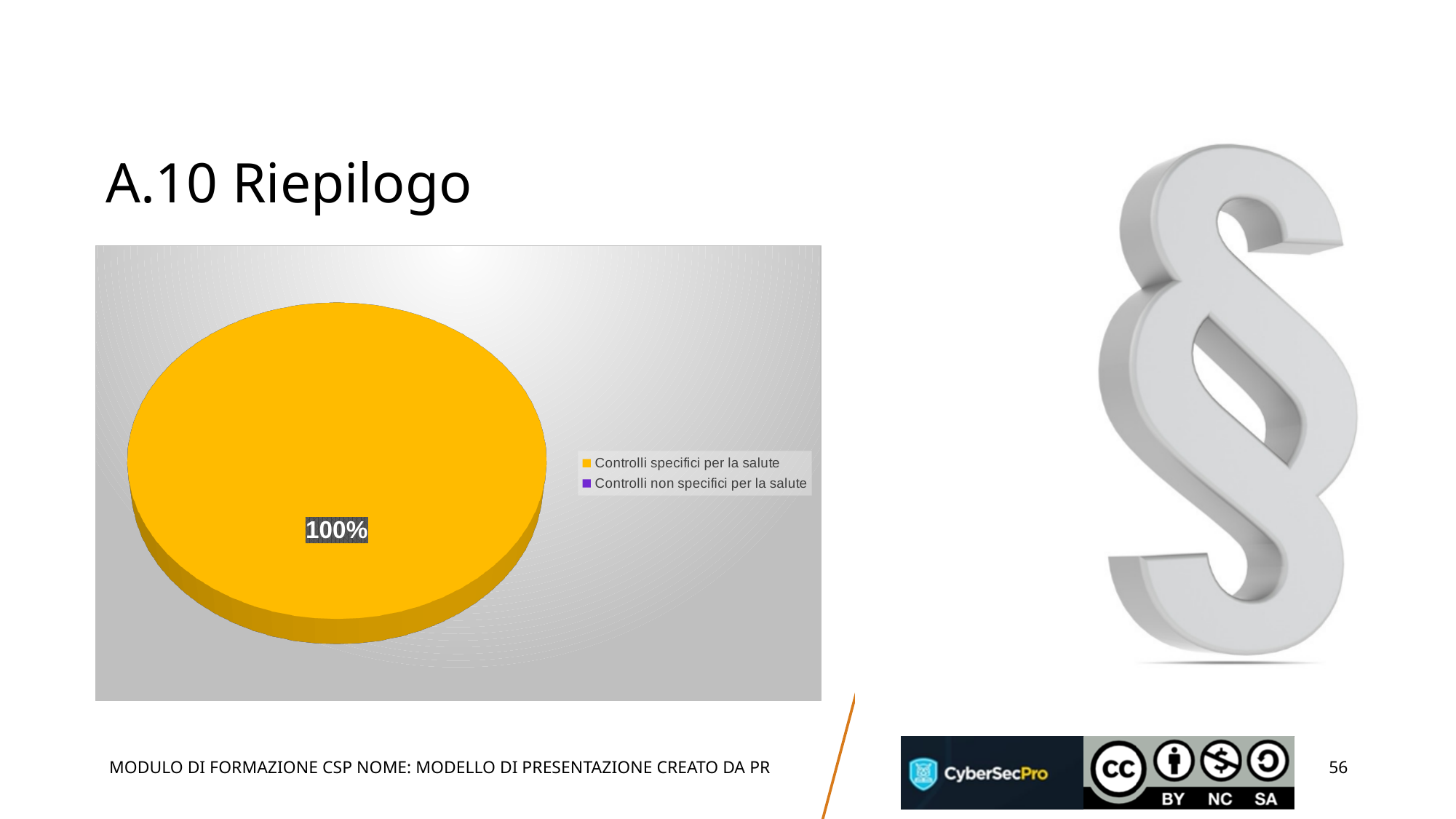
Which is larger in the pie chart, the slice for Controlli specifici per la salute or the slice for Controlli non specifici per la salute? Controlli specifici per la salute Which category has the largest slice in the pie chart? Controlli specifici per la salute What percentage is printed on the pie chart? 100% What share of the pie does the slice for Controlli specifici per la salute represent? 100% What kind of chart is shown on the slide? pie chart Is the share for Controlli specifici per la salute greater or less than 50%? greater Which legend entry is shown in purple? Controlli non specifici per la salute How many entries does the legend of the pie chart list? 2 Which legend entry is shown in yellow? Controlli specifici per la salute How many slices are visible in the pie chart? 1